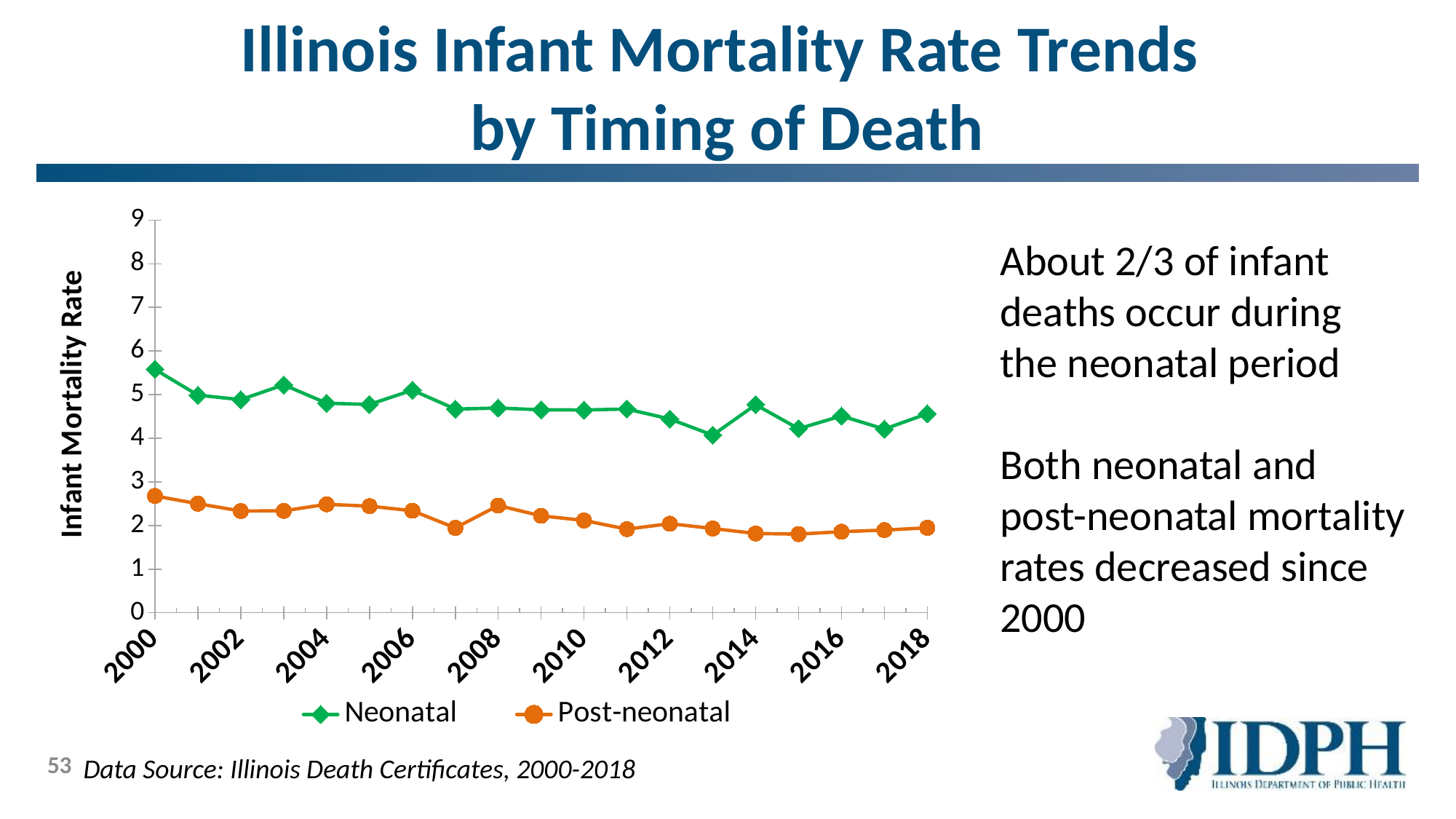
Is the Post-neonatal value for 2000 greater or less than 2? greater Which series has the larger value in 2010, Neonatal or Post-neonatal? Neonatal In which year is the Post-neonatal mortality rate highest? 2000 What kind of chart is shown on the slide? Line chart How many series does the chart's legend list? 2 How many years (data points) does each series cover, from 2000 to 2018? 19 Does the Neonatal mortality rate generally rise or fall from 2000 to 2018? Fall What is the label of the chart's vertical axis? Infant Mortality Rate In which year is the Neonatal mortality rate highest? 2000 Is the Neonatal value for 2013 greater or less than 5? less Which two series are plotted in the chart? Neonatal and Post-neonatal Is the Neonatal value for 2000 greater or less than 5? greater